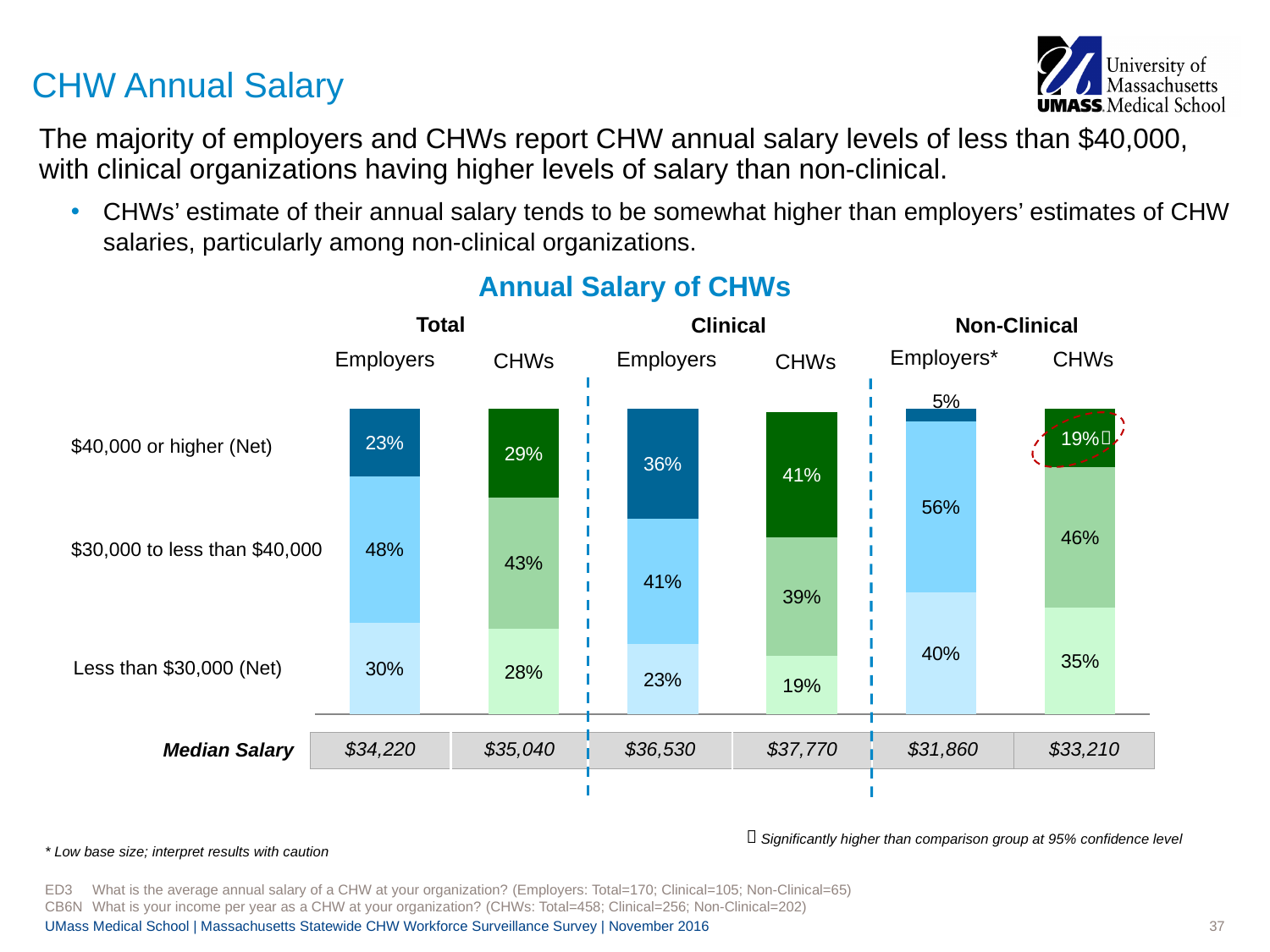
How many bars are plotted in the chart? 6 What percentage of Clinical CHWs report an annual salary of less than $30,000 (Net)? 19% Which bar has the lowest share in the $40,000 or higher (Net) category? Non-Clinical Employers* What kind of chart is shown under the title "Annual Salary of CHWs"? Stacked bar chart What is the difference between the $40,000 or higher (Net) share for Clinical CHWs and Clinical Employers? 5 percentage points Which is larger: the Less than $30,000 (Net) share for Non-Clinical Employers or for Non-Clinical CHWs? Non-Clinical Employers What is the median salary shown for Clinical CHWs? $37,770 What percentage of Total Employers report CHW annual salaries of $40,000 or higher (Net)? 23% Which group has the lowest median salary shown? Non-Clinical Employers* Which bar has the highest share in the $40,000 or higher (Net) category? Clinical CHWs What percentage of Non-Clinical Employers report CHW salaries of $30,000 to less than $40,000? 56% How many salary categories are stacked in each bar? 3